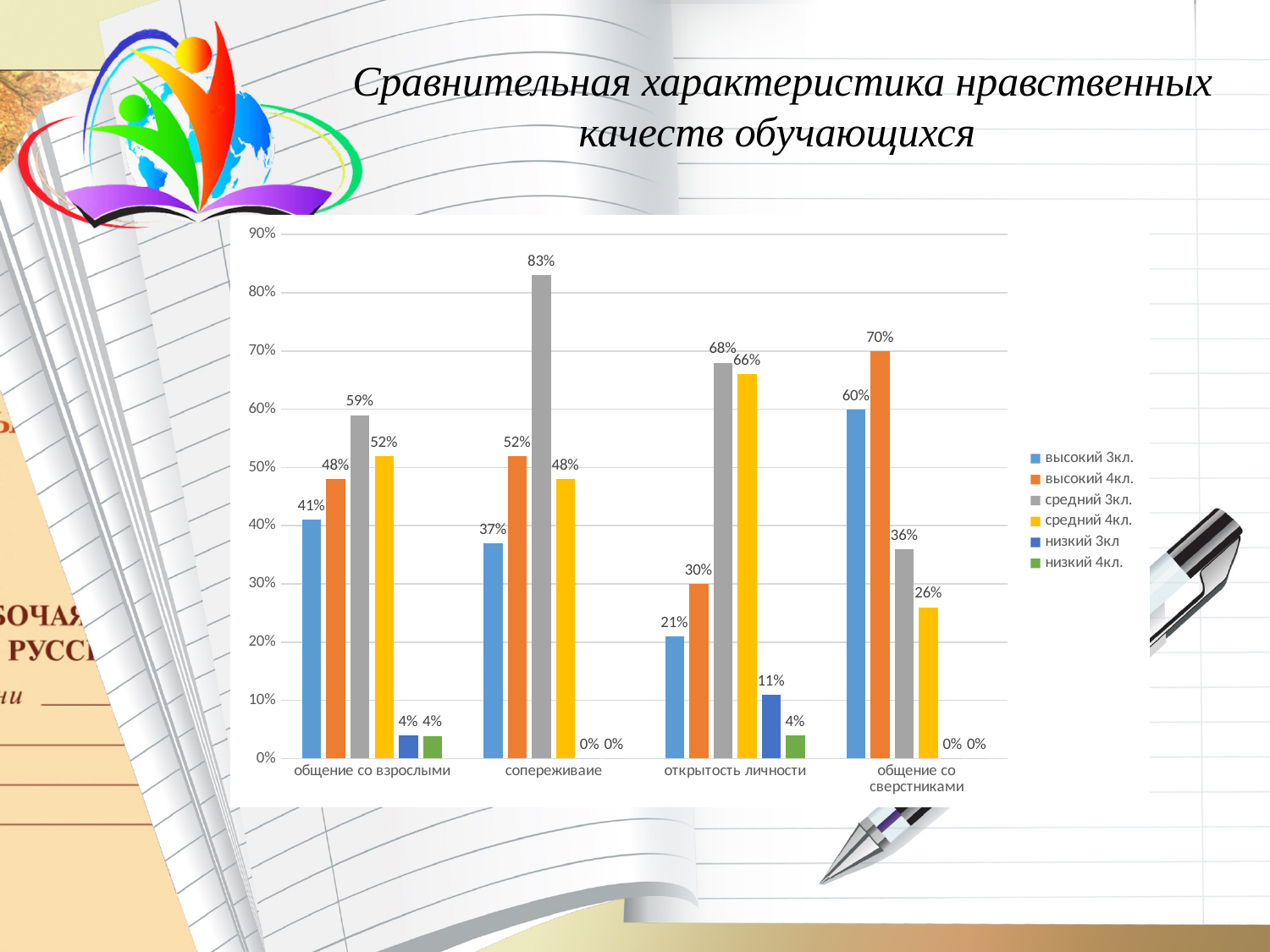
What is the title of the slide? Сравнительная характеристика нравственных качеств обучающихся For открытость личности, which is larger: средний 3кл. or средний 4кл.? средний 3кл. How many categories are shown on the x axis? 4 Which category has the lowest value for высокий 3кл.? открытость личности What is the value of высокий 4кл. for общение со сверстниками? 70% How many series does the legend list? 6 What is the value of средний 3кл. for сопереживаие? 83% Is the value of средний 4кл. for общение со сверстниками greater or less than 30%? less What is the difference between высокий 4кл. and высокий 3кл. for общение со взрослыми? 7% Which category has the highest value for средний 3кл.? сопереживаие What type of chart is shown on the slide? bar chart What is the value of низкий 3кл for открытость личности? 11%